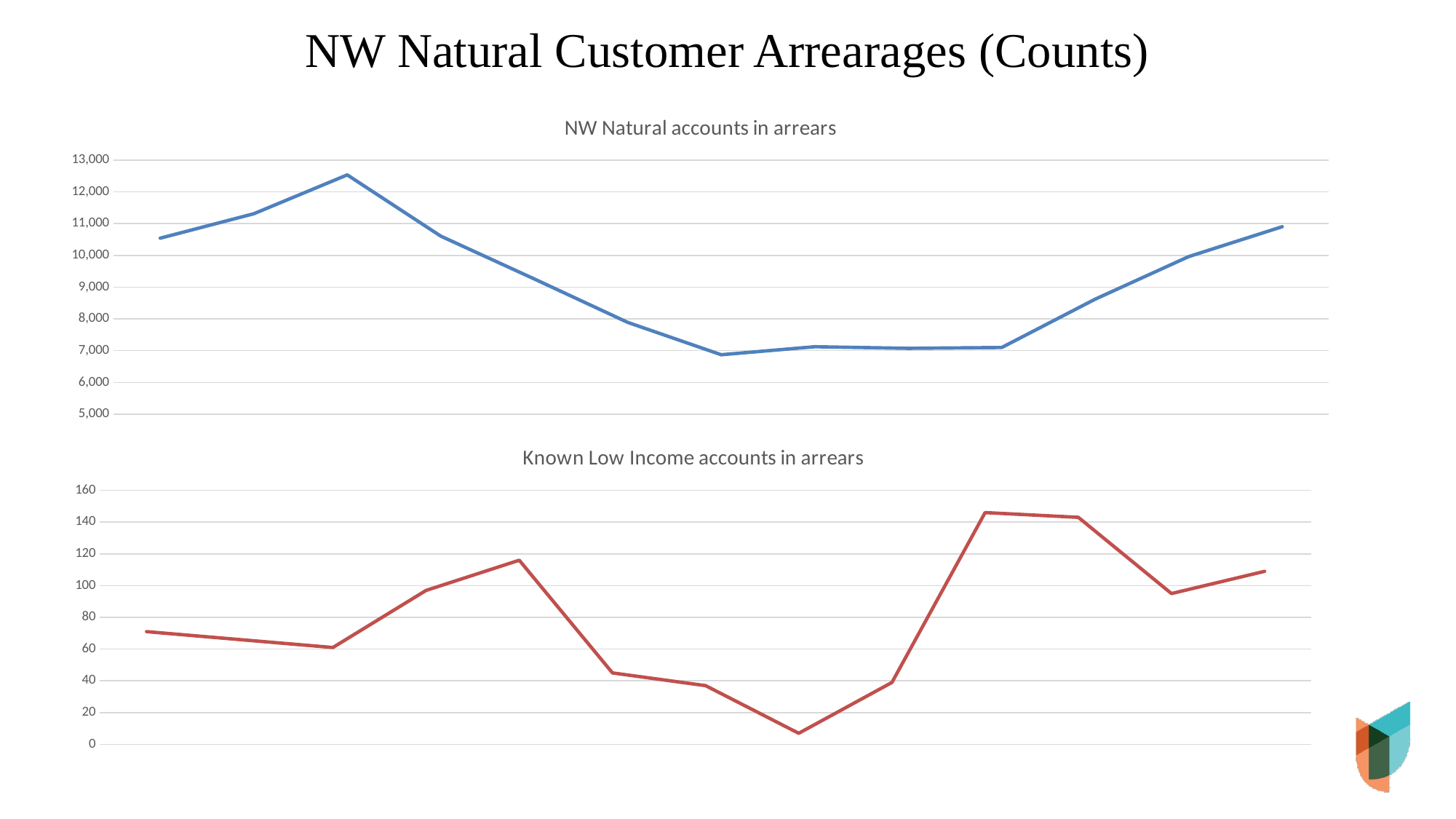
What kind of chart is the top chart, 'NW Natural accounts in arrears'? line chart In the bottom chart, 'Known Low Income accounts in arrears', how many data points are plotted on the line? 13 What colour is the line in the bottom chart, 'Known Low Income accounts in arrears'? red In the top chart, 'NW Natural accounts in arrears', is the highest point on the line greater or less than 12,000? greater In the top chart, 'NW Natural accounts in arrears', does the line rise or fall from the third point to the seventh point? fall What kind of chart is the bottom chart, 'Known Low Income accounts in arrears'? line chart In the bottom chart, 'Known Low Income accounts in arrears', is the highest point on the line greater or less than 140? greater In the bottom chart, 'Known Low Income accounts in arrears', which is higher, the first point or the last point on the line? the last point In the bottom chart, 'Known Low Income accounts in arrears', is the lowest point on the line greater or less than 20? less In the top chart, 'NW Natural accounts in arrears', how many data points are plotted on the line? 13